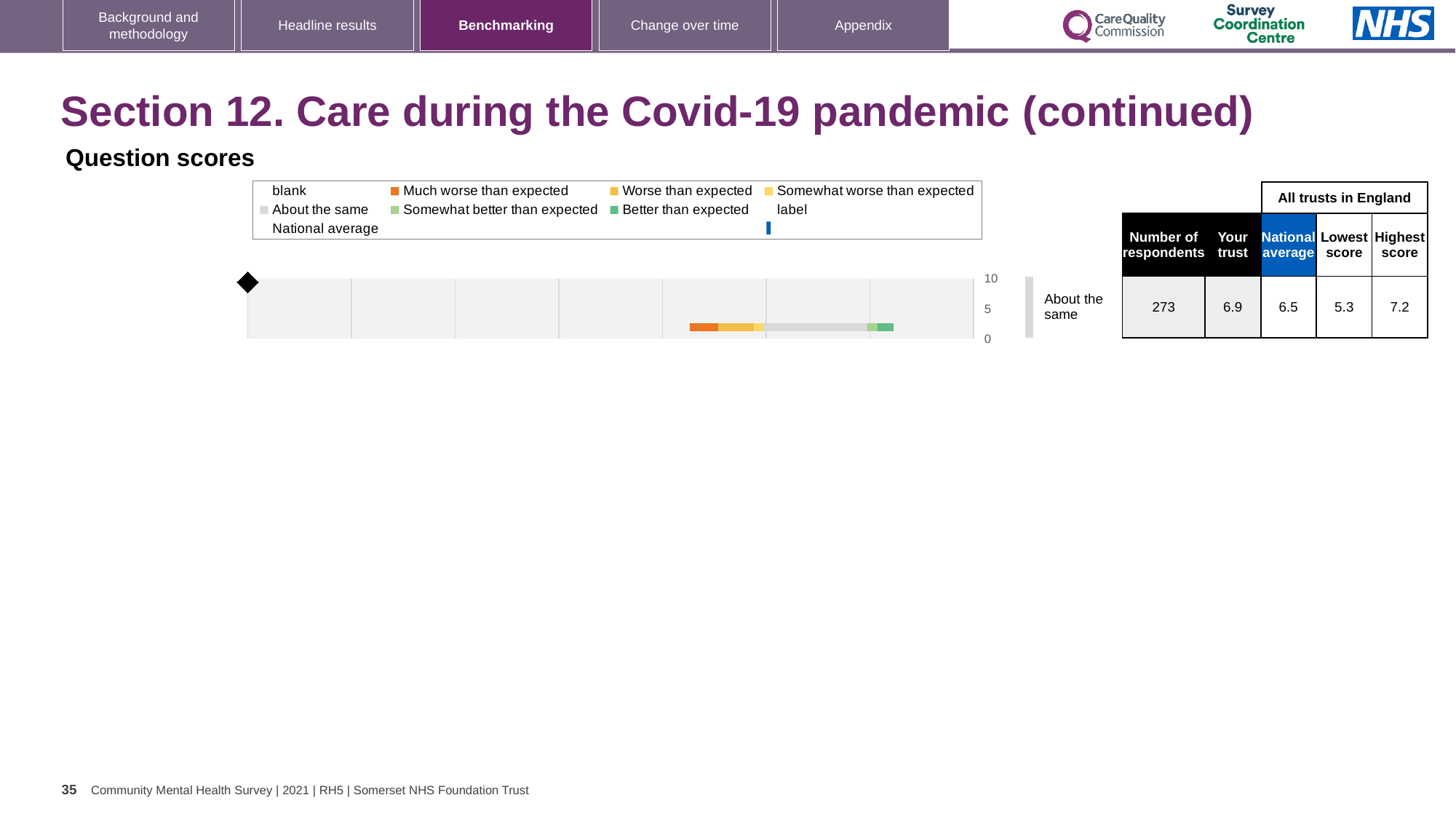
What is the label of the single category plotted in the question scores chart? About the same How many categories (rows) are plotted in the question scores chart? 1 Which is larger, the 'Your trust' score or the National average score? Your trust What colour does the legend use for 'Much worse than expected'? orange In the table beside the chart, what is the Highest score across all trusts in England? 7.2 How many respondents are listed for the 'About the same' row? 273 What kind of chart is shown under 'Question scores'? bar chart In the table beside the chart, what is the Lowest score across all trusts in England? 5.3 In the table beside the chart, what is the 'Your trust' score for the 'About the same' row? 6.9 What is the highest value shown on the chart's score axis? 10 In the table beside the chart, what is the National average score? 6.5 What is the difference between the 'Your trust' score and the National average score? 0.4